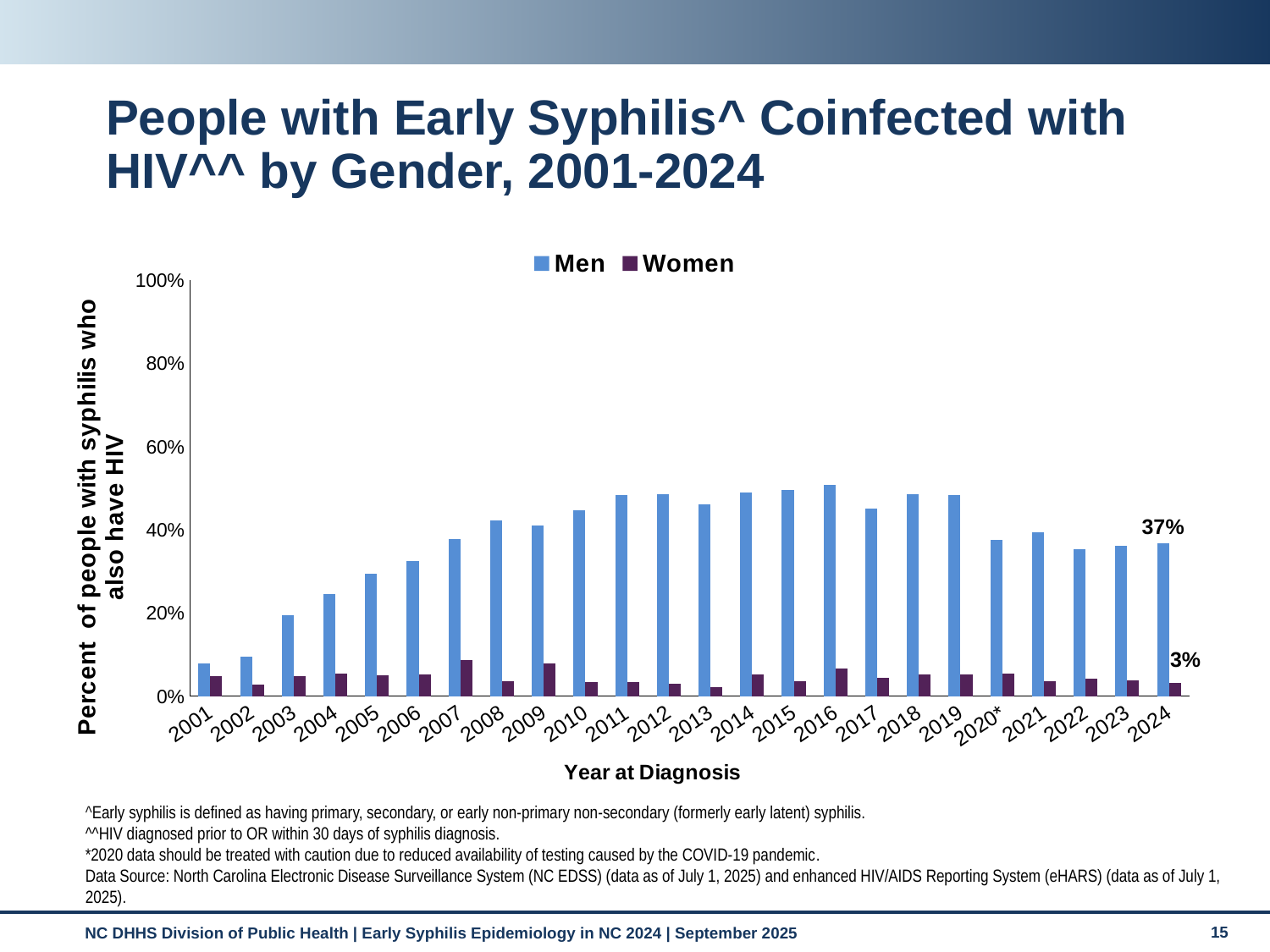
What percent of women with early syphilis also had HIV in 2024? 3% Which year has the larger Men value, 2001 or 2016? 2016 Do the Men values rise or fall from 2001 to 2011? Rise How many series does the legend list? 2 What is the difference between the Men and Women values in 2024? 34% Is the value for Men in 2016 greater or less than 40%? greater What percent of men with early syphilis also had HIV in 2024? 37% What kind of chart is shown on the slide? Bar chart How many years are shown on the x axis? 24 Is the value for Women in 2010 greater or less than 20%? less Is the value for Men in 2001 greater or less than 20%? less In 2024, which group has the higher percentage coinfected with HIV, Men or Women? Men